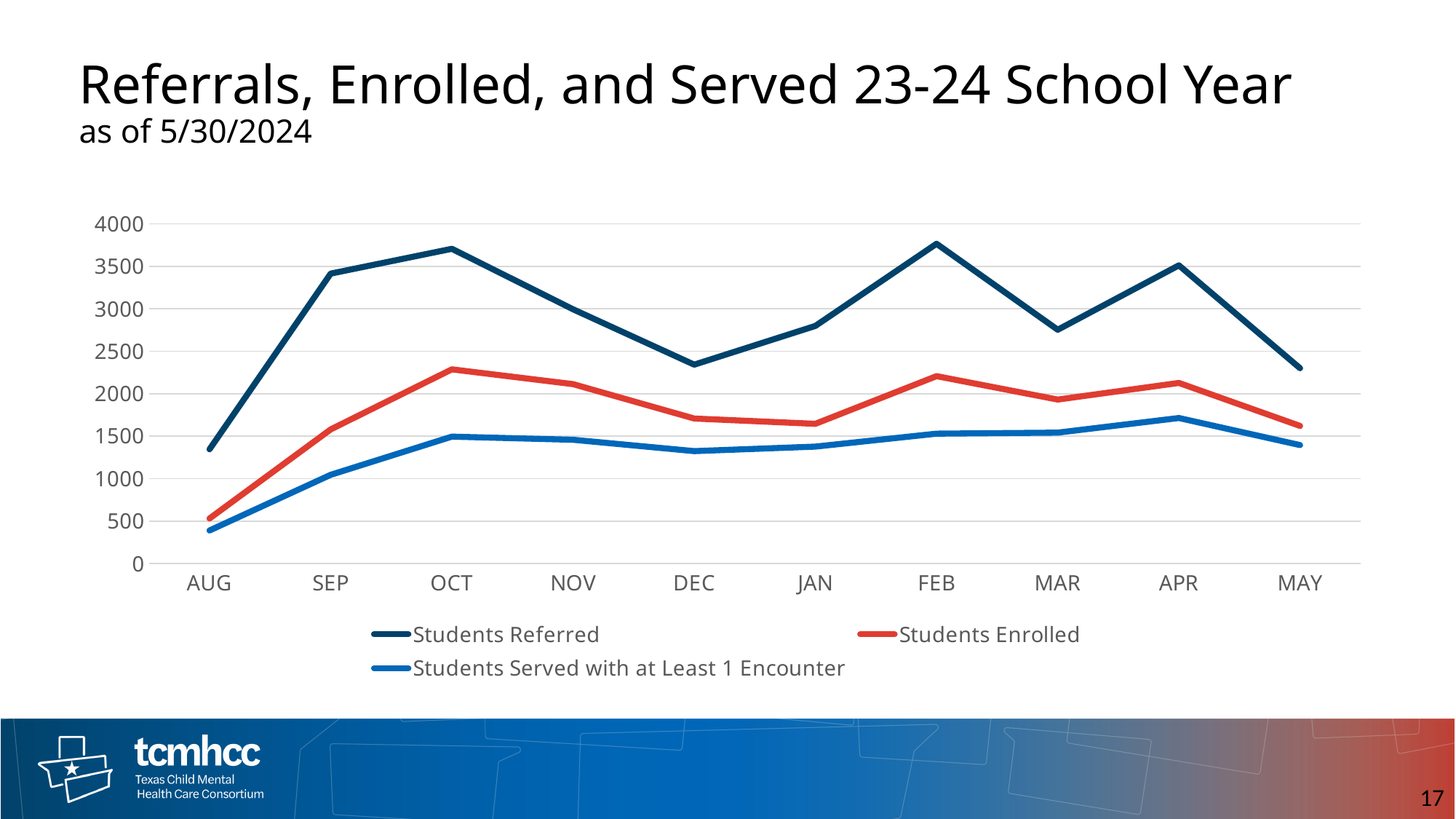
Is the value for Students Referred in OCT greater or less than 3500? greater In which month is the Students Served with at Least 1 Encounter line at its highest? APR In which month is the Students Referred line at its lowest? AUG Is the value for Students Served with at Least 1 Encounter in APR greater or less than 1500? greater Which is larger, Students Referred in SEP or Students Referred in MAR? SEP How many series does the legend list? 3 Is the value for Students Referred in DEC greater or less than 2500? less Does the Students Referred line rise or fall from OCT to DEC? fall How many months are plotted along the x axis? 10 What kind of chart is shown on the slide? line chart In which month is the Students Enrolled line at its lowest? AUG